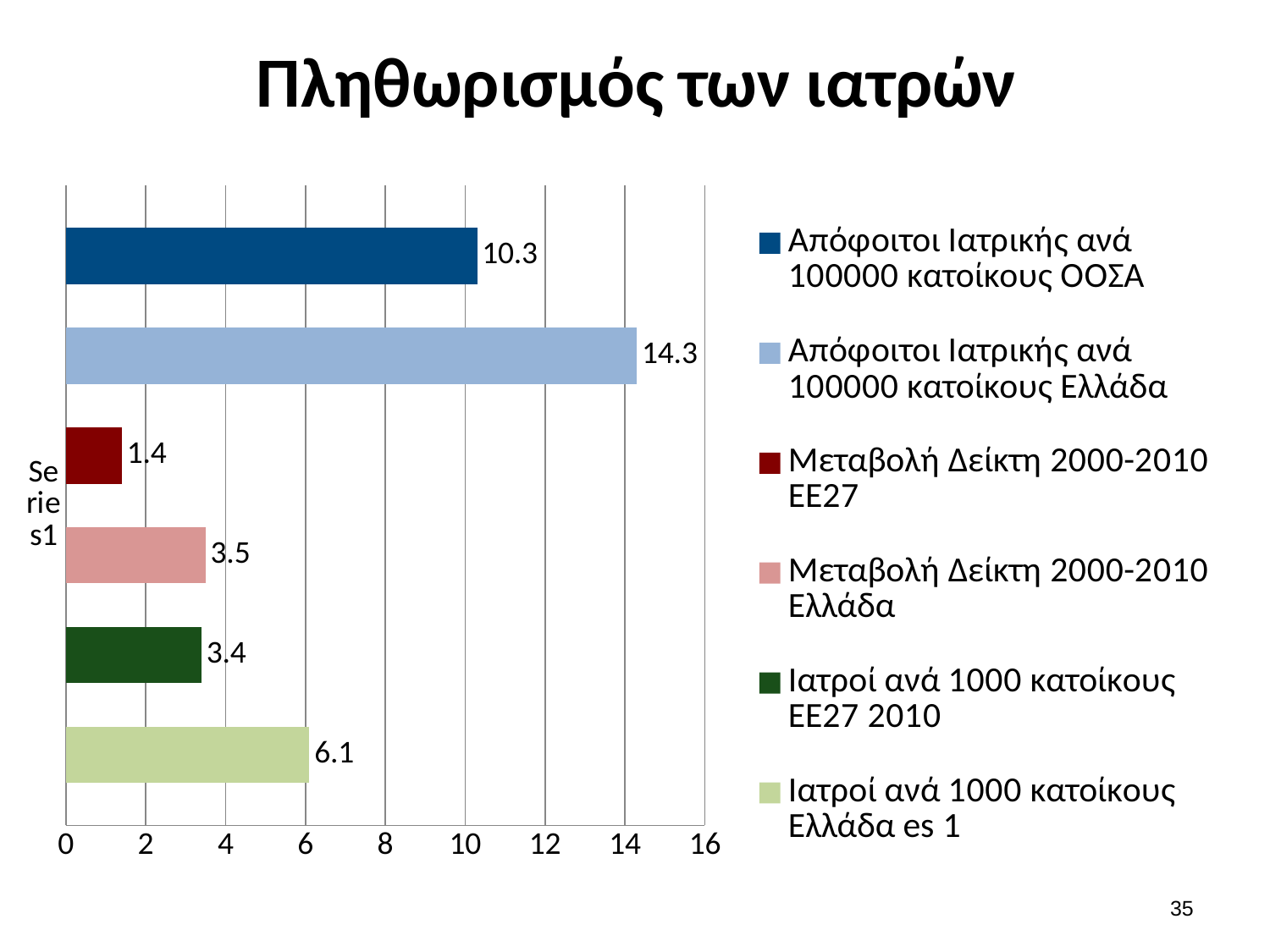
What is the value for Απόφοιτοι Ιατρικής ανά 100000 κατοίκους Ελλάδα? 14.3 What is the value for Ιατροί ανά 1000 κατοίκους Ελλάδα es 1? 6.1 How many series does the legend list? 6 What is the difference between the values for Απόφοιτοι Ιατρικής ανά 100000 κατοίκους Ελλάδα and Απόφοιτοι Ιατρικής ανά 100000 κατοίκους ΟΟΣΑ? 4 What is the value for Μεταβολή Δείκτη 2000-2010 ΕΕ27? 1.4 Which is larger: the value for Ιατροί ανά 1000 κατοίκους Ελλάδα es 1 or the value for Ιατροί ανά 1000 κατοίκους ΕΕ27 2010? Ιατροί ανά 1000 κατοίκους Ελλάδα es 1 What is the value for Απόφοιτοι Ιατρικής ανά 100000 κατοίκους ΟΟΣΑ? 10.3 What kind of chart is shown on the slide? bar chart Is the value for Απόφοιτοι Ιατρικής ανά 100000 κατοίκους ΟΟΣΑ greater or less than 8? greater Which series has the highest value? Απόφοιτοι Ιατρικής ανά 100000 κατοίκους Ελλάδα What is the title of the chart? Πληθωρισμός των ιατρών Which series has the lowest value? Μεταβολή Δείκτη 2000-2010 ΕΕ27